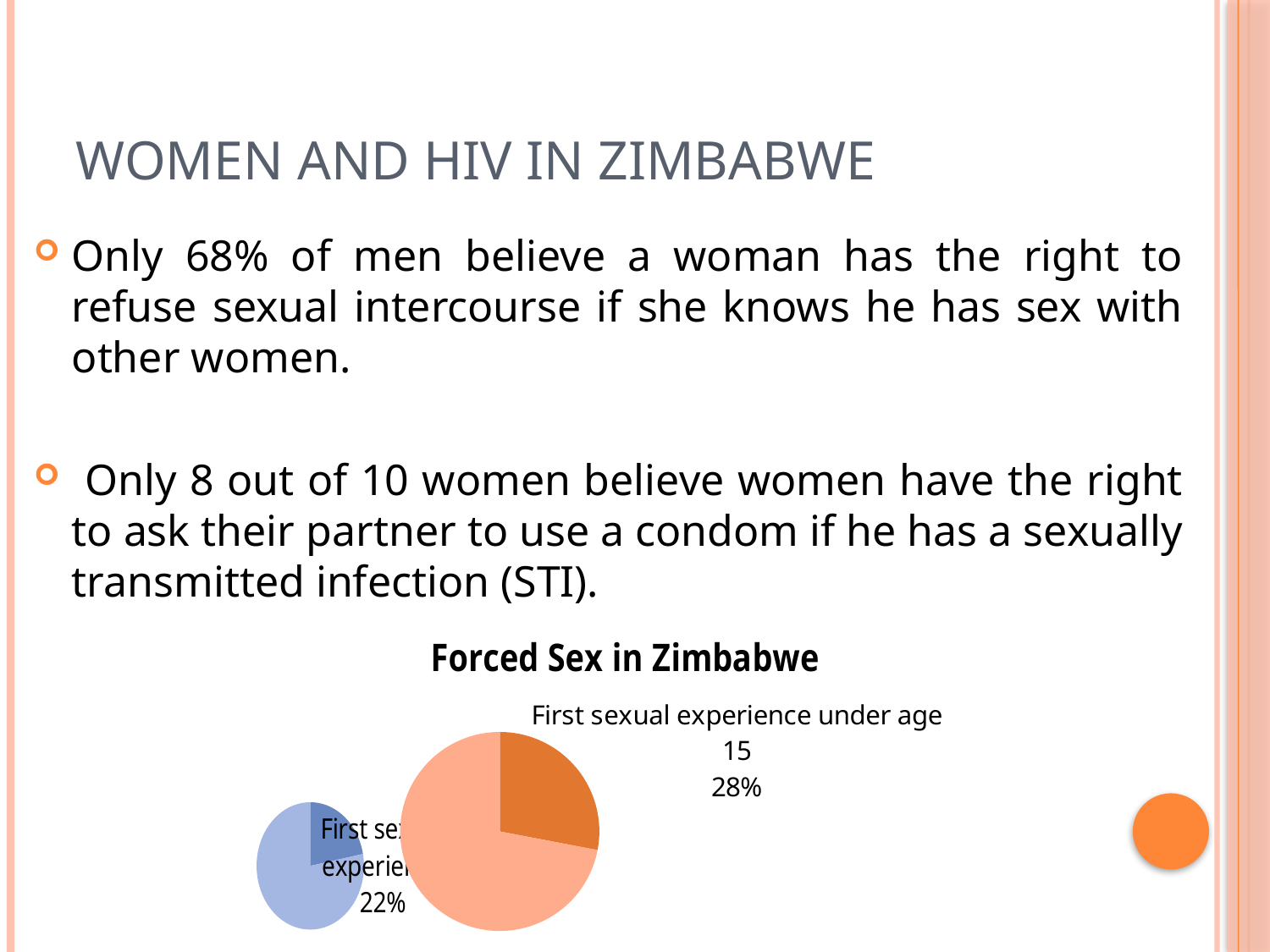
What is the title of the chart on the slide? Forced Sex in Zimbabwe In the 'Forced Sex in Zimbabwe' chart, which is larger: the 'First sexual experience under age 15' value on the orange pie or the value labelled on the smaller blue pie? First sexual experience under age 15 (28%) In the 'Forced Sex in Zimbabwe' chart, what percentage is shown for 'First sexual experience under age 15'? 28% In the 'Forced Sex in Zimbabwe' chart, what colour is the slice for 'First sexual experience under age 15'? Dark orange What kind of chart is used in the 'Forced Sex in Zimbabwe' chart? Pie chart How many pie charts are shown under the 'Forced Sex in Zimbabwe' title? 2 In the 'Forced Sex in Zimbabwe' chart, what percentage is labelled on the smaller blue pie? 22% In the 'Forced Sex in Zimbabwe' chart, what share of the larger orange pie does the 'First sexual experience under age 15' slice represent? 28% In the 'Forced Sex in Zimbabwe' chart, what is the difference between the 28% value on the orange pie and the 22% value on the blue pie? 6 percentage points